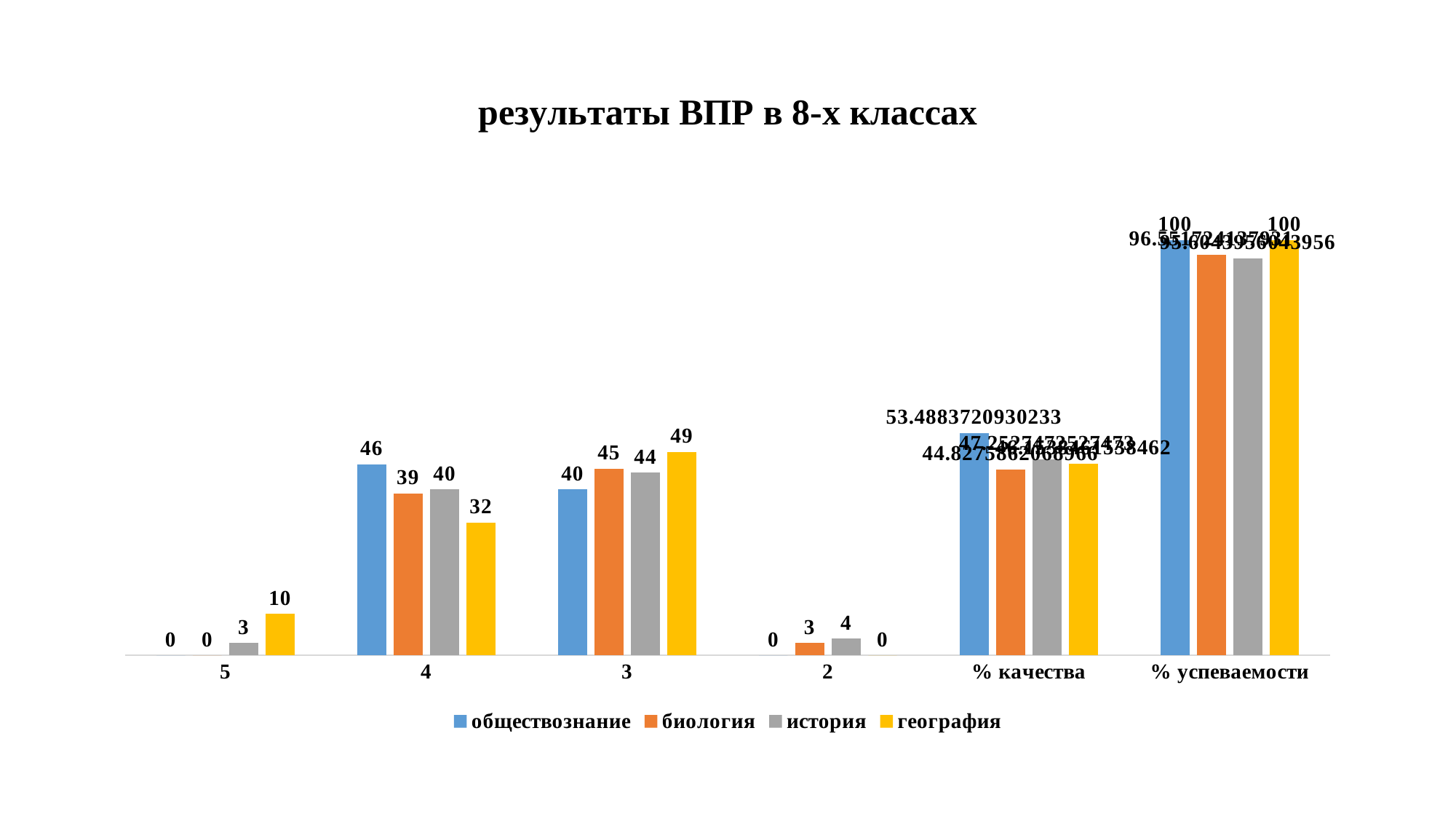
What kind of chart is shown on the slide? bar chart What is the difference between обществознание and география in category 4? 14 Which is larger in category 2: биология or история? история How many series does the legend list? 4 What is the title of the chart? результаты ВПР в 8-х классах What is the value for история in category 3? 44 What is the value for география in category 5? 10 How many categories are shown on the x axis? 6 Which series has the highest value in category 3? география What is the value for обществознание in the % успеваемости category? 100 What is the value for обществознание in category 4? 46 Which series has the lowest value in category 4? география